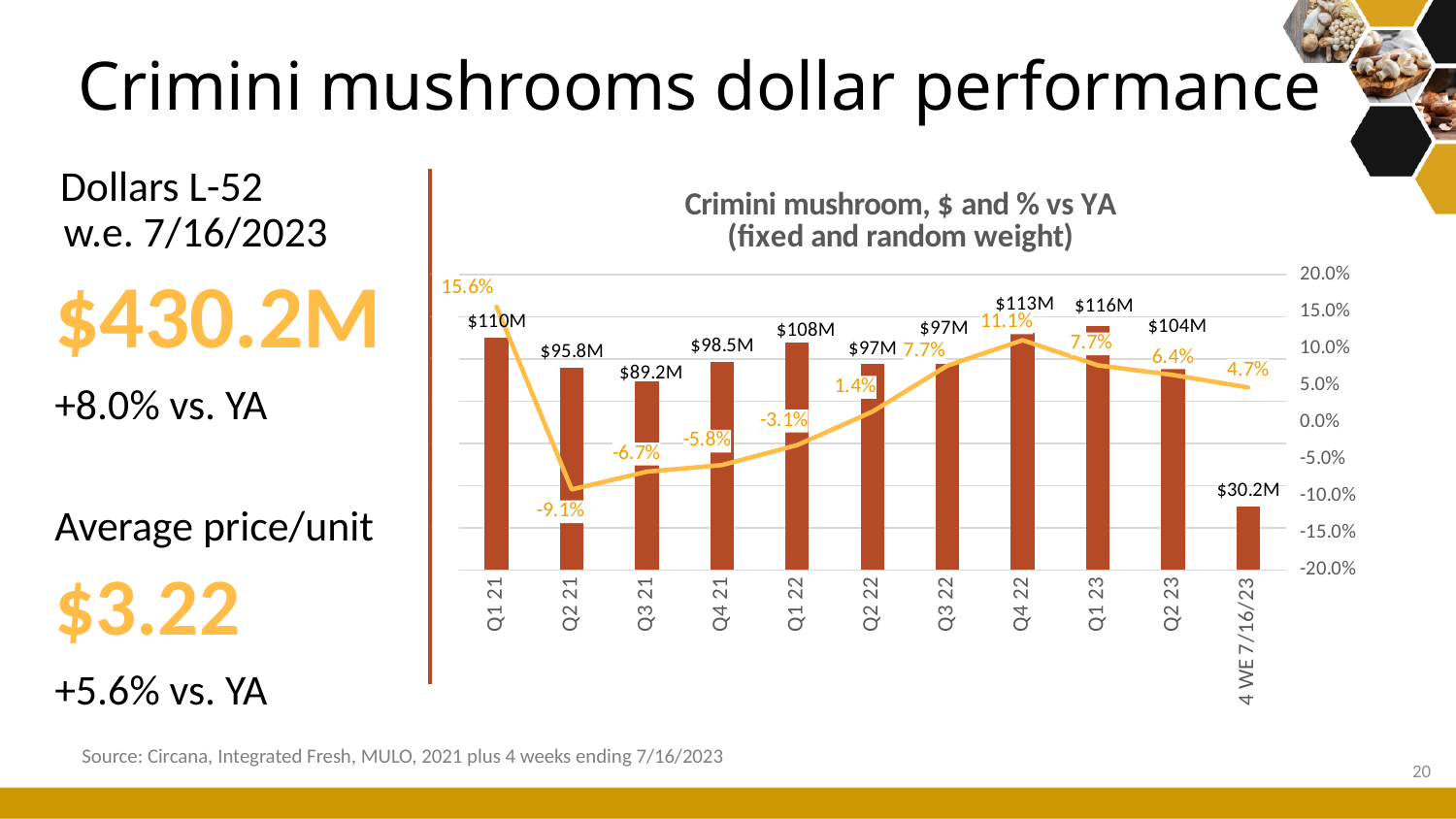
Which has the larger dollar value, Q1 21 or Q1 22? Q1 21 Which period has the highest % vs YA value on the line? Q1 21 What is the % vs YA value shown for Q4 22? 11.1% What is the % vs YA value shown for Q2 21? -9.1% What kind of chart is used to show the dollar values in the chart titled "Crimini mushroom, $ and % vs YA"? Bar chart What is the dollar value shown for the 4 WE 7/16/23 period? $30.2M Which period has the lowest % vs YA value on the line? Q2 21 How many periods are shown on the x axis of the chart? 11 Which period has the highest dollar value bar? Q1 23 What is the dollar value shown for Q1 23? $116M Which period has the lowest dollar value bar? 4 WE 7/16/23 What is the difference in dollar value between Q1 23 and Q2 23? $12M